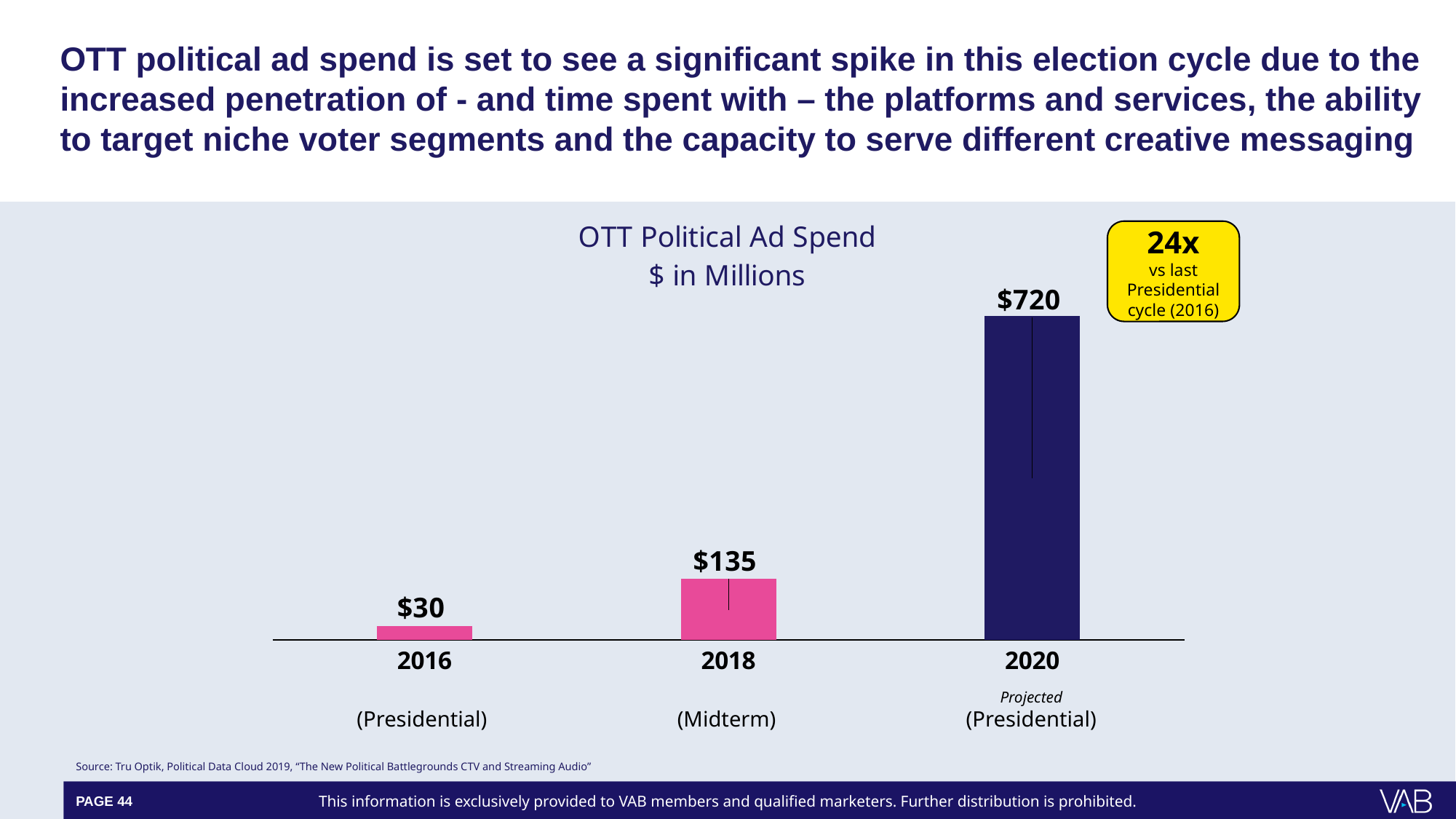
According to the callout on the chart, how many times larger is the 2020 spend than the last Presidential cycle (2016)? 24x Which is larger, the OTT political ad spend for 2018 or for 2016? 2018 What is the OTT political ad spend shown for 2018? $135 What is the difference between the 2018 and 2016 OTT political ad spend values? $105 What is the difference between the 2020 and 2016 OTT political ad spend values? $690 Which year has the lowest OTT political ad spend on the chart? 2016 What kind of chart is shown on the slide? Bar chart Which year has the highest OTT political ad spend on the chart? 2020 What is the projected OTT political ad spend shown for 2020? $720 How many years are plotted on the chart? 3 What is the OTT political ad spend shown for 2016? $30 Do the OTT political ad spend values rise or fall from 2016 to 2020? Rise